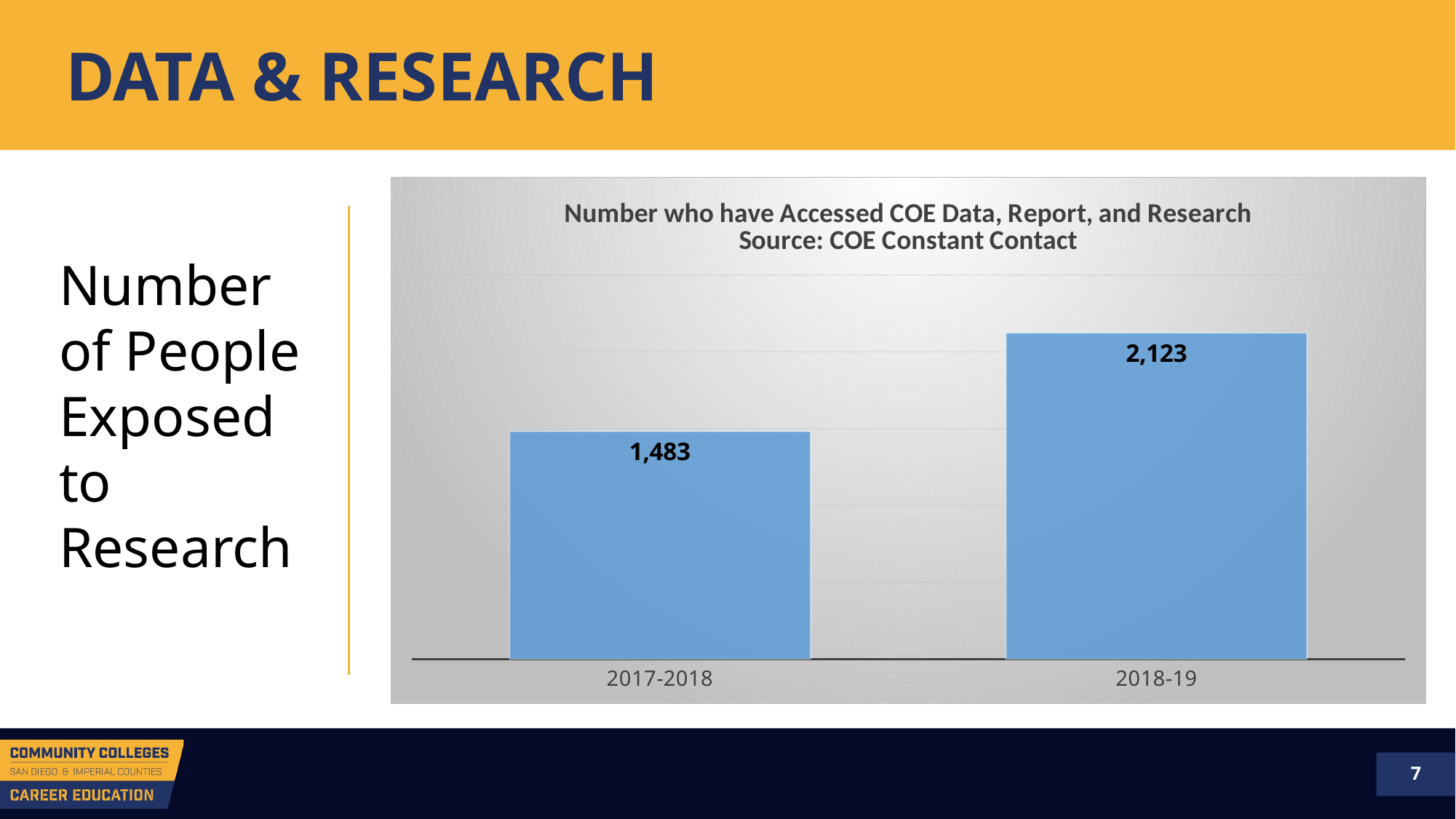
Which category has the highest value? 2018-19 Do the values rise or fall from 2017-2018 to 2018-19? rise What is the value for 2018-19? 2,123 What is the title of the chart? Number who have Accessed COE Data, Report, and Research Which is larger, the value for 2017-2018 or the value for 2018-19? 2018-19 How many categories are shown on the x axis? 2 What is the difference between the values for 2018-19 and 2017-2018? 640 What is the value for 2017-2018? 1,483 What kind of chart is shown on the slide? bar chart Which category has the lowest value? 2017-2018 What source is cited in the chart title? COE Constant Contact